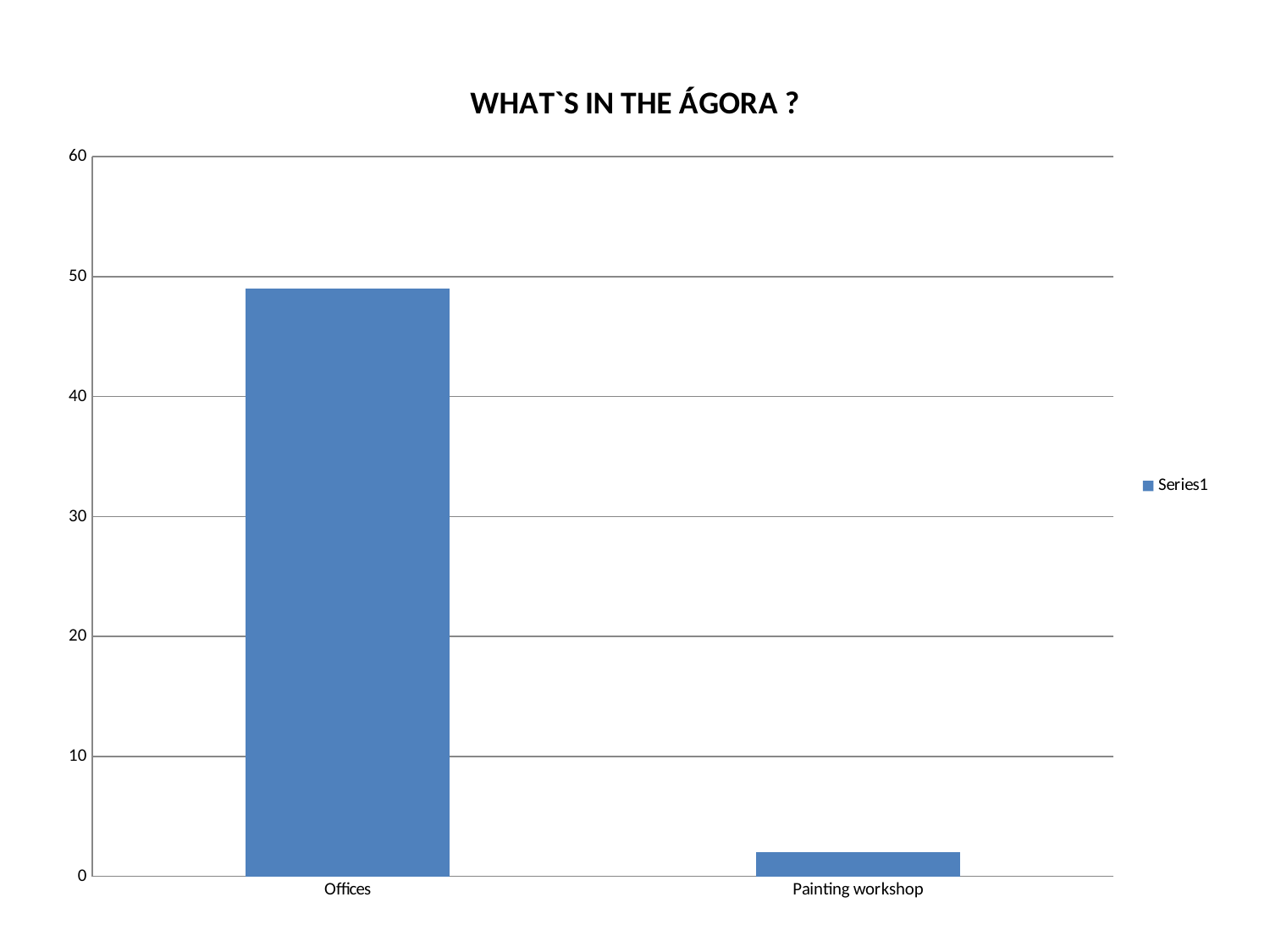
How many categories are shown on the x axis? 2 Which is larger, the value for Offices or the value for Painting workshop? Offices Which category has the lowest value? Painting workshop What type of chart is shown on the slide? bar chart Is the value for Offices greater or less than 40? greater What is the name of the series in the legend? Series1 Do the values rise or fall from left to right along the x axis? fall Is the value for Painting workshop greater or less than 10? less How many series does the legend list? 1 Which category has the highest value? Offices What is the title of the chart? WHAT`S IN THE ÁGORA ?